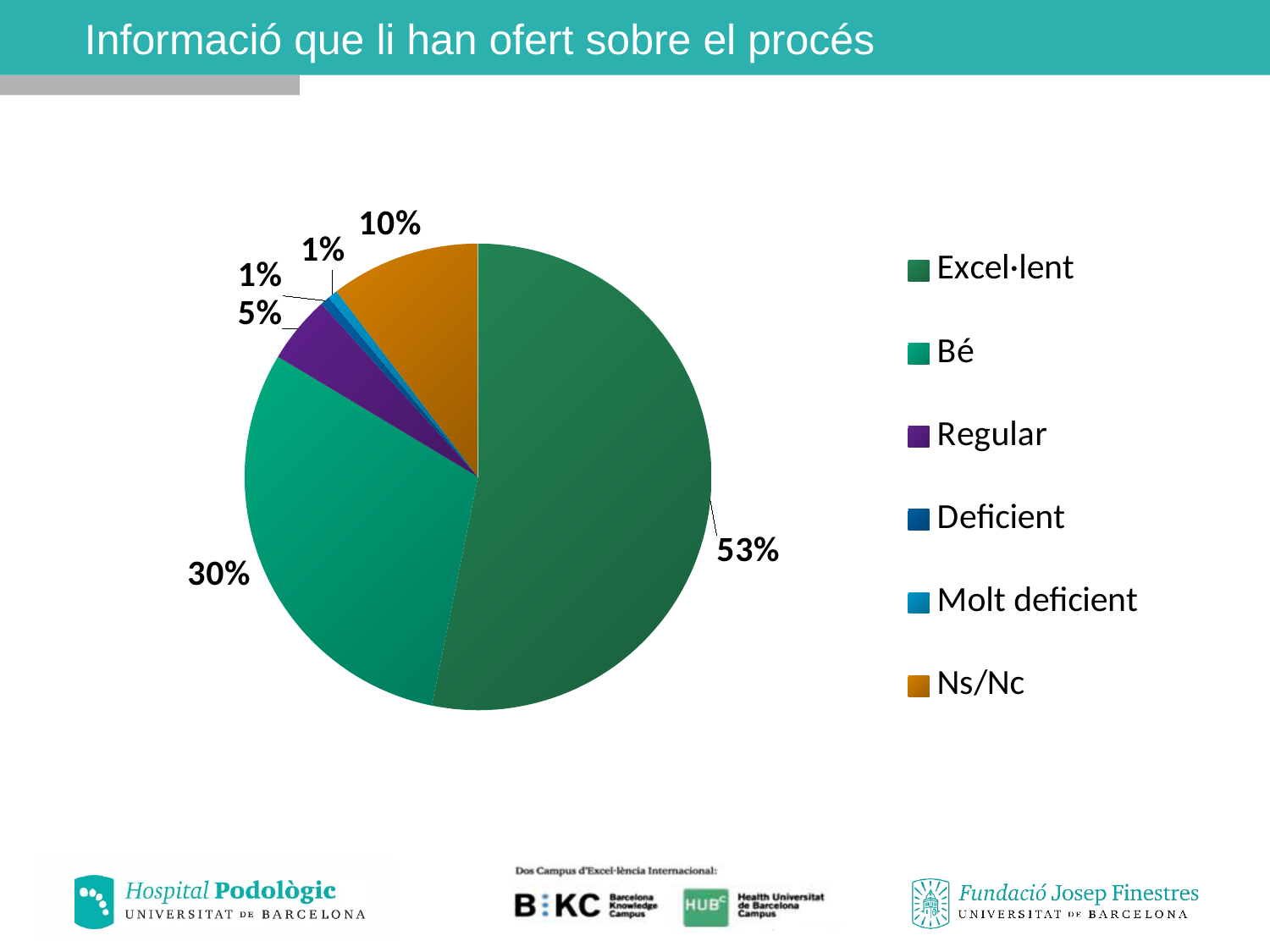
What kind of chart is shown on the slide? pie chart What percentage of the pie corresponds to Excel·lent? 53% What is the title of the slide containing the chart? Informació que li han ofert sobre el procés What percentage of the pie corresponds to Regular? 5% What percentage of the pie corresponds to Bé? 30% What is the combined share of Excel·lent and Bé? 83% Which is larger, the share for Ns/Nc or the share for Regular? Ns/Nc What is the difference in percentage points between Excel·lent and Bé? 23 How many categories does the legend list? 6 Which legend entry is shown in orange? Ns/Nc Which category has the largest share of the pie? Excel·lent What percentage of the pie corresponds to Ns/Nc? 10%